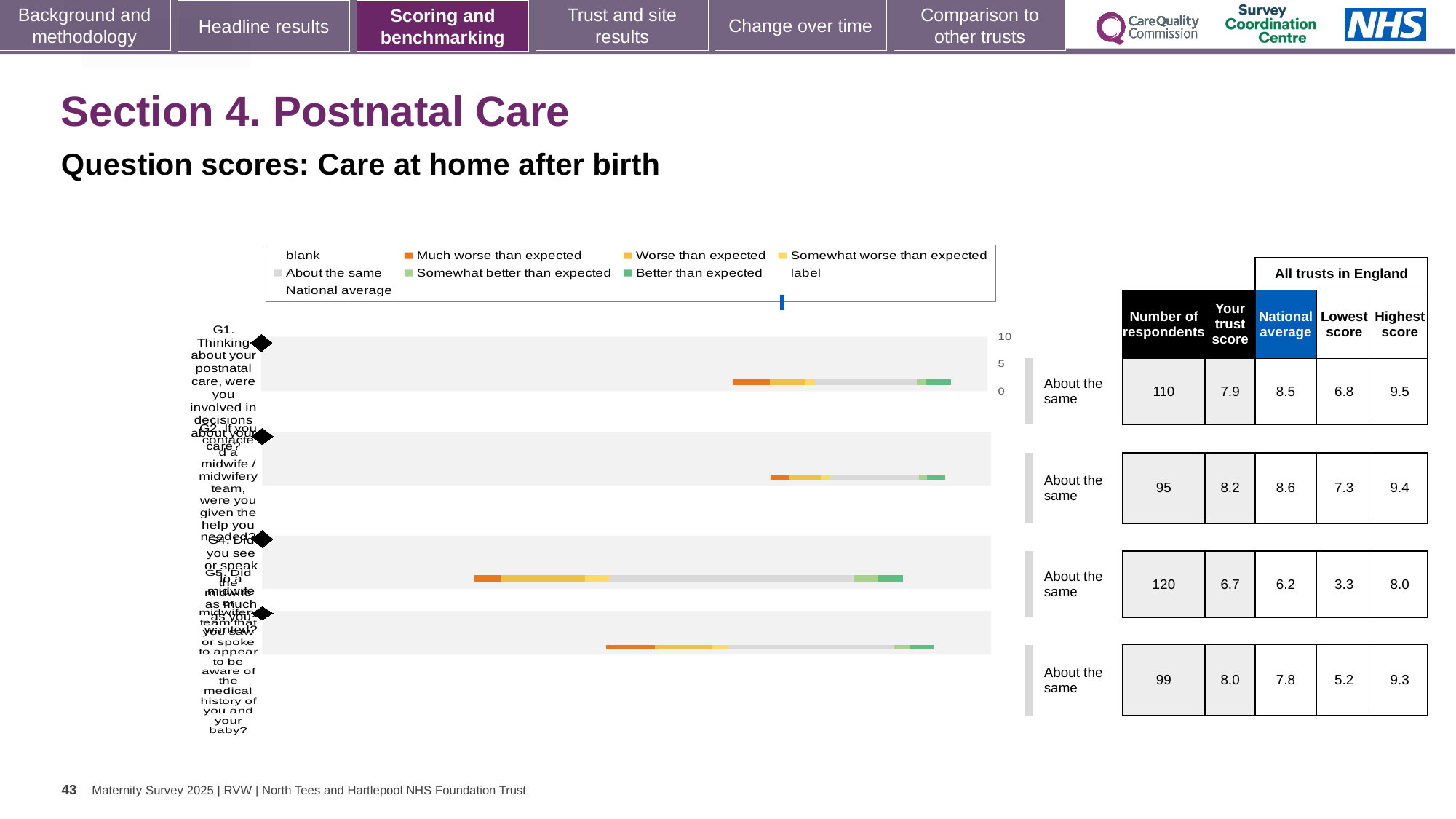
In the table beside the chart, what is the national average for the third question row? 6.2 For the first question row, what is the difference between the national average and the trust score? 0.6 For the third question row, which is larger: the trust score or the national average? the trust score (6.7) In the table beside the chart, what is the number of respondents for the first (top) question row? 110 What kind of chart is shown on the slide? bar chart In the table beside the chart, what is the lowest score for the second question row? 7.3 Which question row has the highest number of respondents in the table beside the chart? the third row (120) How many question rows (bars) are plotted in the chart? 4 In the table beside the chart, what is the highest score for the fourth (bottom) question row? 9.3 What benchmark label is printed to the right of each bar in the chart? About the same In the table beside the chart, what is the 'Your trust score' for the second question row? 8.2 Which question row has the lowest 'Lowest score' value in the table beside the chart? the third row (3.3)